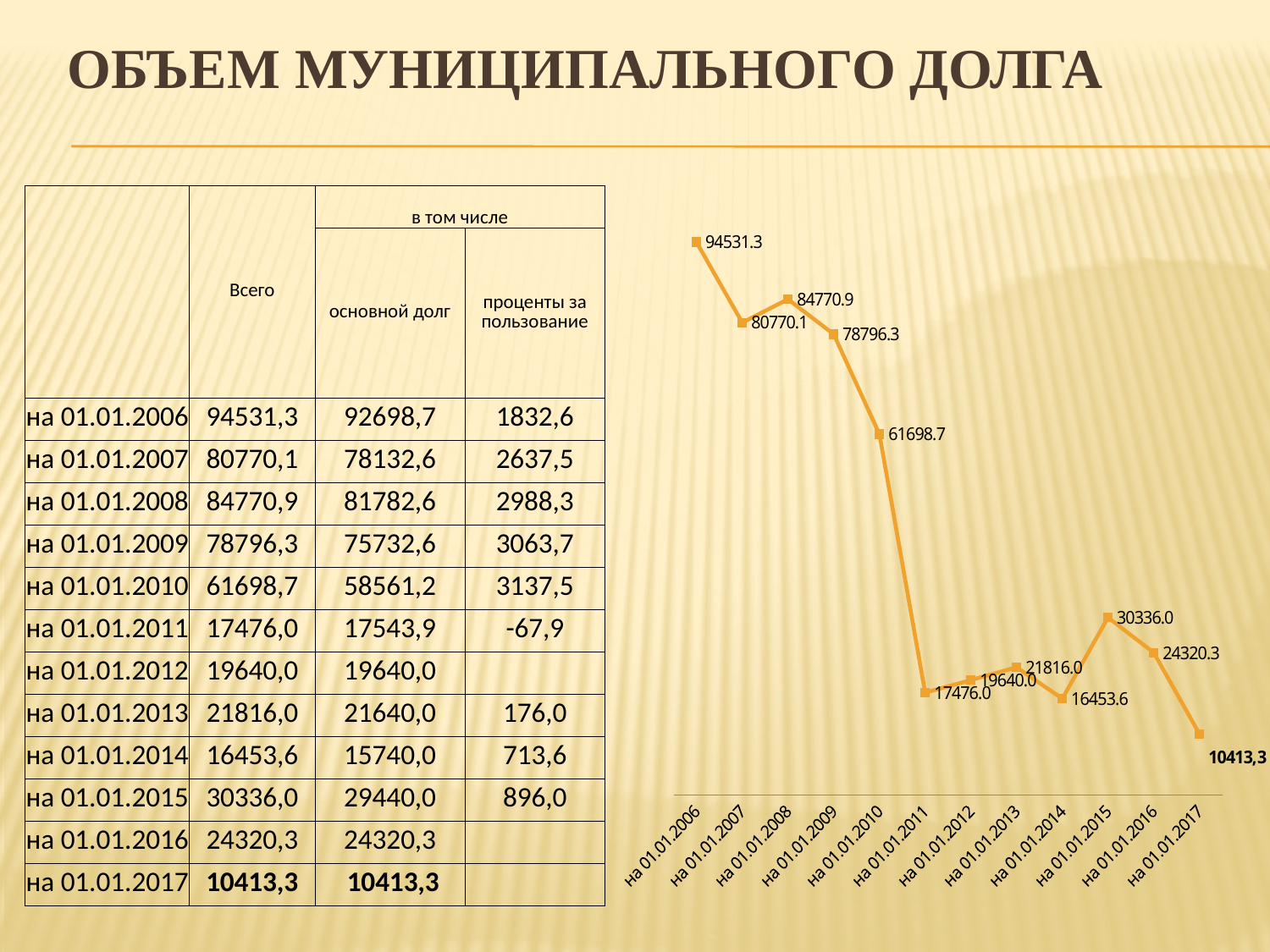
What type of chart is shown on the slide? line chart Which date has the lowest value on the line chart? на 01.01.2017 What is the value plotted for на 01.01.2010 on the line chart? 61698.7 Which is larger on the line chart: the value for на 01.01.2013 or the value for на 01.01.2014? на 01.01.2013 What is the value plotted for на 01.01.2017 on the line chart? 10413,3 What is the value plotted for на 01.01.2006 on the line chart? 94531.3 What is the value plotted for на 01.01.2015 on the line chart? 30336.0 How many data points are plotted on the line chart? 12 What is the difference between the values for на 01.01.2008 and на 01.01.2007 on the line chart? 4000.8 Which date has the highest value on the line chart? на 01.01.2006 Does the value on the line chart generally rise or fall from на 01.01.2006 to на 01.01.2017? fall What is the title of the slide containing the line chart? ОБЪЕМ МУНИЦИПАЛЬНОГО ДОЛГА